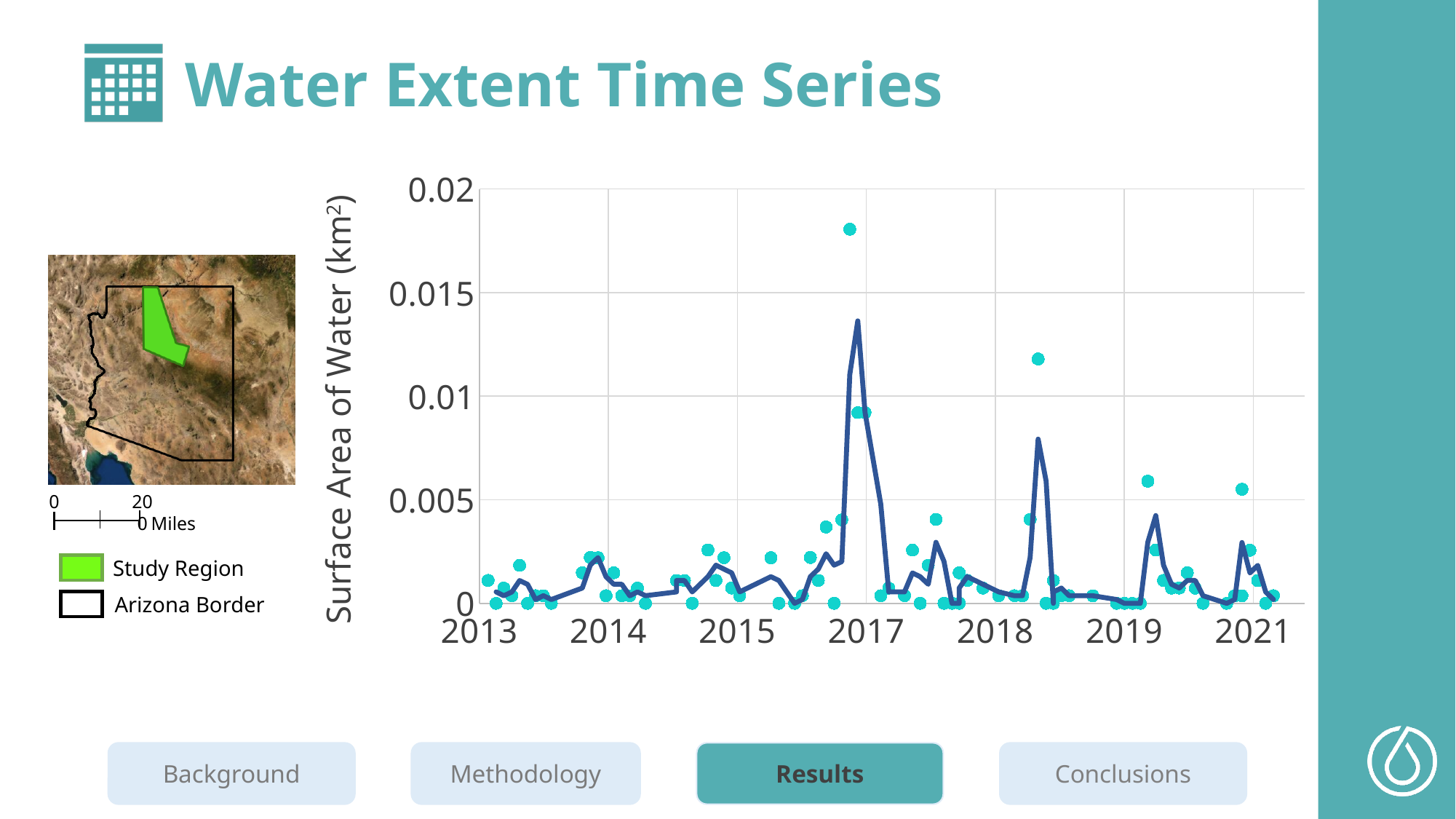
Is the peak of the line near 2017 greater or less than 0.01? greater Is the highest scatter point in 2018 greater or less than 0.01? greater Is the peak of the line in 2019 greater or less than 0.005? less What is the label of the y axis of the chart? Surface Area of Water (km²) What is the title of the slide containing the chart? Water Extent Time Series Near which labelled year does the line reach its highest value? 2017 What kind of chart is shown on the slide? line chart How many year labels are shown on the x axis? 7 Which is larger: the peak of the line near 2017 or the peak of the line in 2018? 2017 What is the highest value shown on the y axis? 0.02